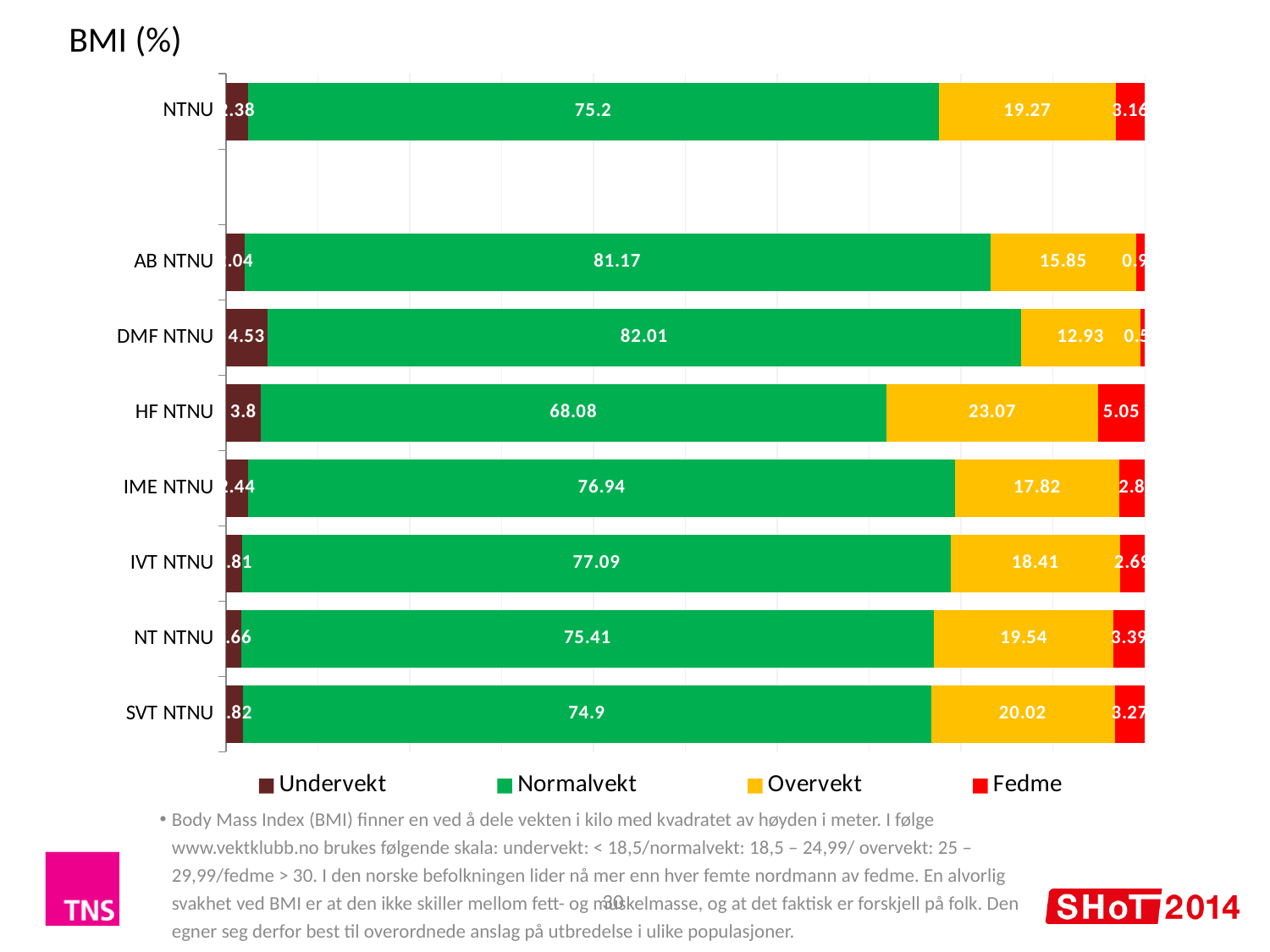
What is the Normalvekt value for DMF NTNU? 82.01 Which has the larger Overvekt value, NT NTNU or SVT NTNU? SVT NTNU Which category has the highest Normalvekt value? DMF NTNU How many categories (faculties/units) are plotted on the chart? 8 What is the Undervekt value for DMF NTNU? 4.53 Which category has the lowest Normalvekt value? HF NTNU What kind of chart is shown on the slide? Stacked bar chart How many series does the legend list? 4 What is the difference between the Normalvekt values for DMF NTNU and HF NTNU? 13.93 Which category has the highest Overvekt value? HF NTNU What is the Overvekt value for HF NTNU? 23.07 What is the Fedme value for HF NTNU? 5.05